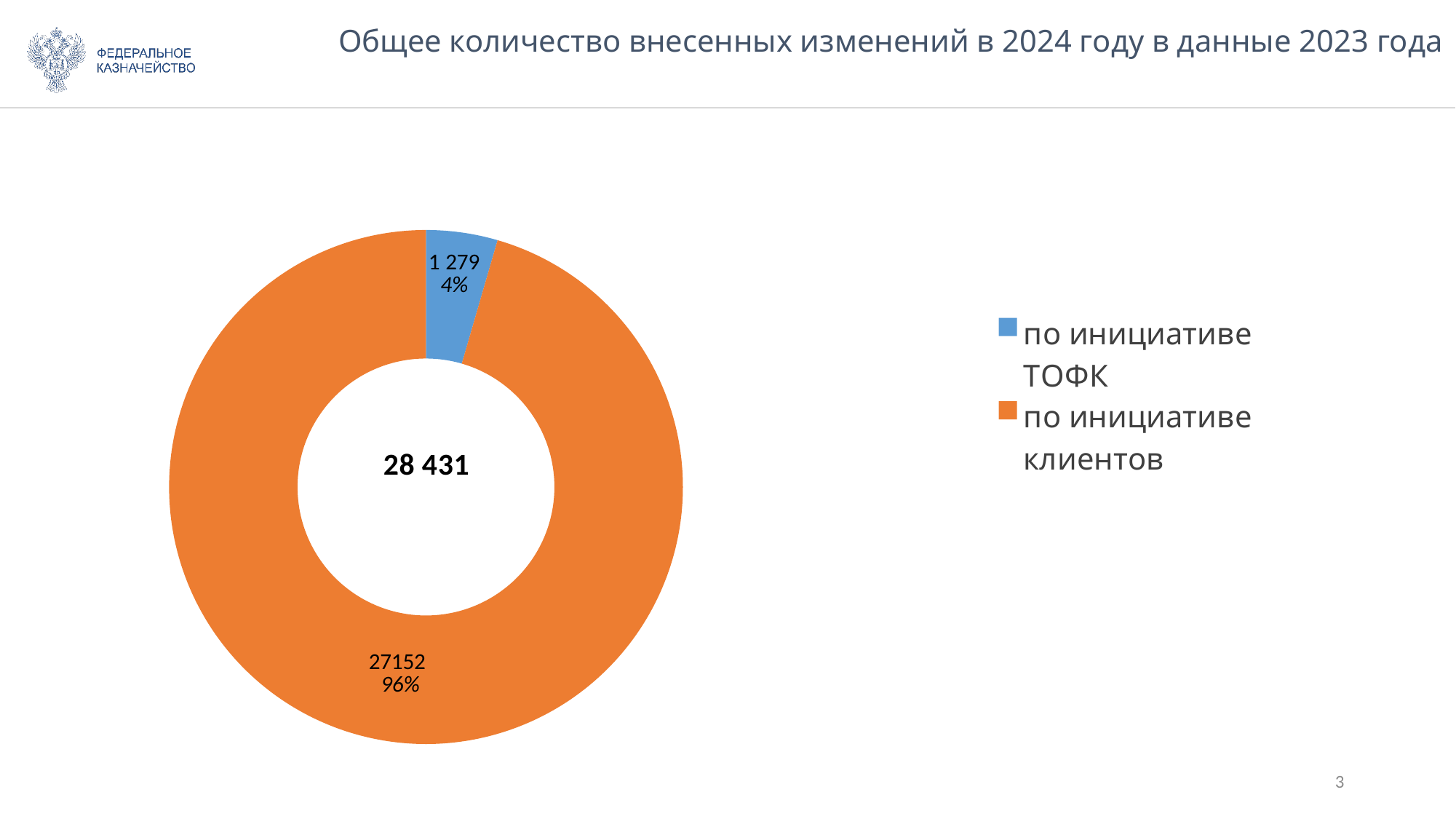
What is the value for "по инициативе ТОФК"? 1 279 What colour is the slice for "по инициативе клиентов"? Orange What share of the chart does "по инициативе клиентов" represent? 96% Which is larger: "по инициативе ТОФК" or "по инициативе клиентов"? по инициативе клиентов Which category has the largest slice? по инициативе клиентов What is the difference between the values for "по инициативе клиентов" and "по инициативе ТОФК"? 25 873 What share of the chart does "по инициативе ТОФК" represent? 4% What total is shown in the centre of the doughnut chart? 28 431 How many categories does the chart show? 2 What is the value for "по инициативе клиентов"? 27152 What kind of chart is shown on the slide? Doughnut (pie) chart Which category has the smallest slice? по инициативе ТОФК